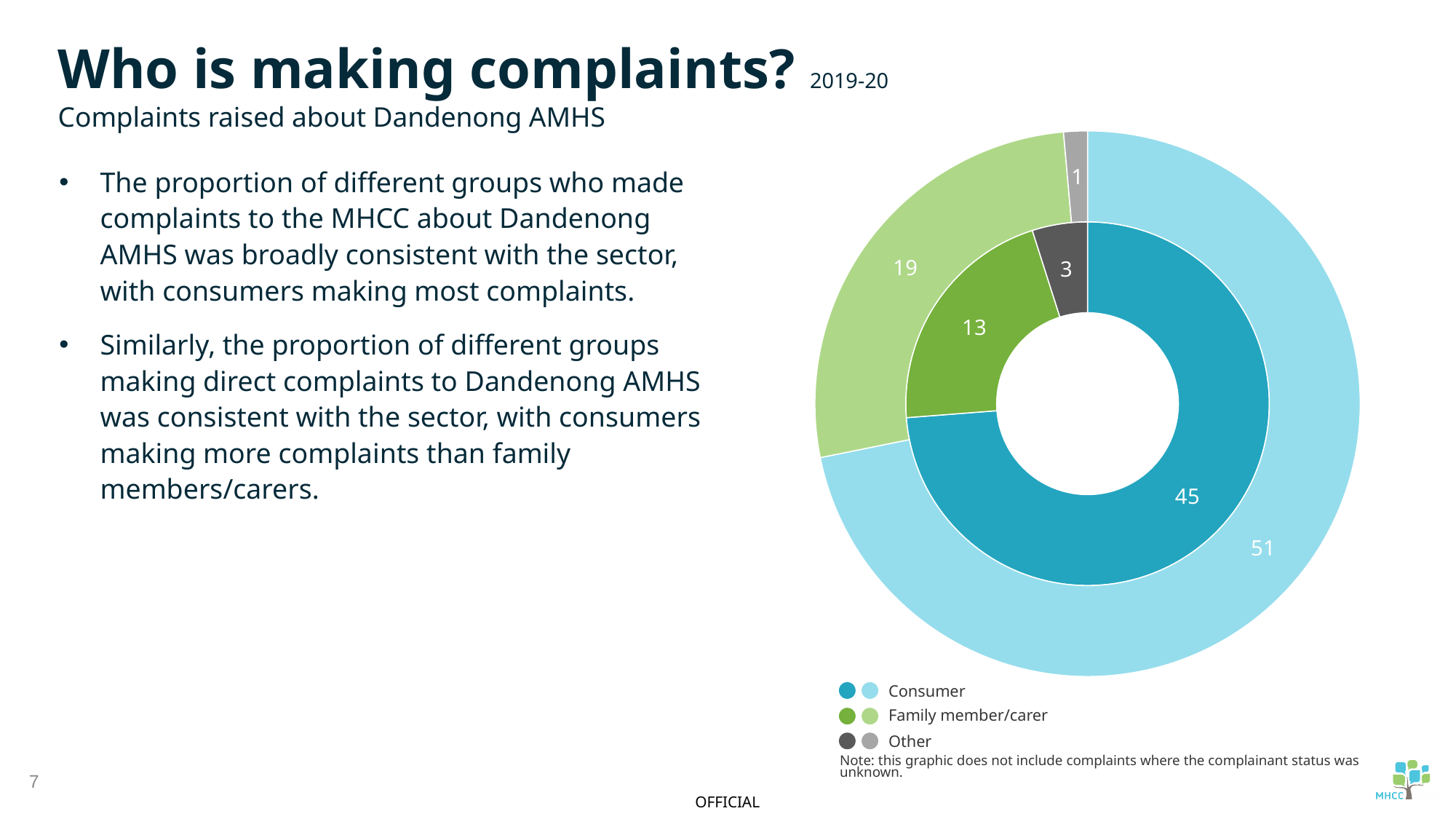
How many categories does the legend of the chart list? 3 What is the difference between the Consumer and Family member/carer values in the inner ring of the chart? 32 What is the value for Other in the inner ring of the chart? 3 Which category has the smallest segment in the inner ring of the chart? Other What is the value for Consumer in the outer ring of the chart? 51 What is the value for Family member/carer in the inner ring of the chart? 13 Which is larger in the outer ring of the chart: Family member/carer or Other? Family member/carer What kind of chart is shown on the slide? Doughnut chart What is the value for Other in the outer ring of the chart? 1 What is the value for Family member/carer in the outer ring of the chart? 19 What is the value for Consumer in the inner ring of the chart? 45 Which category has the largest segment in the outer ring of the chart? Consumer